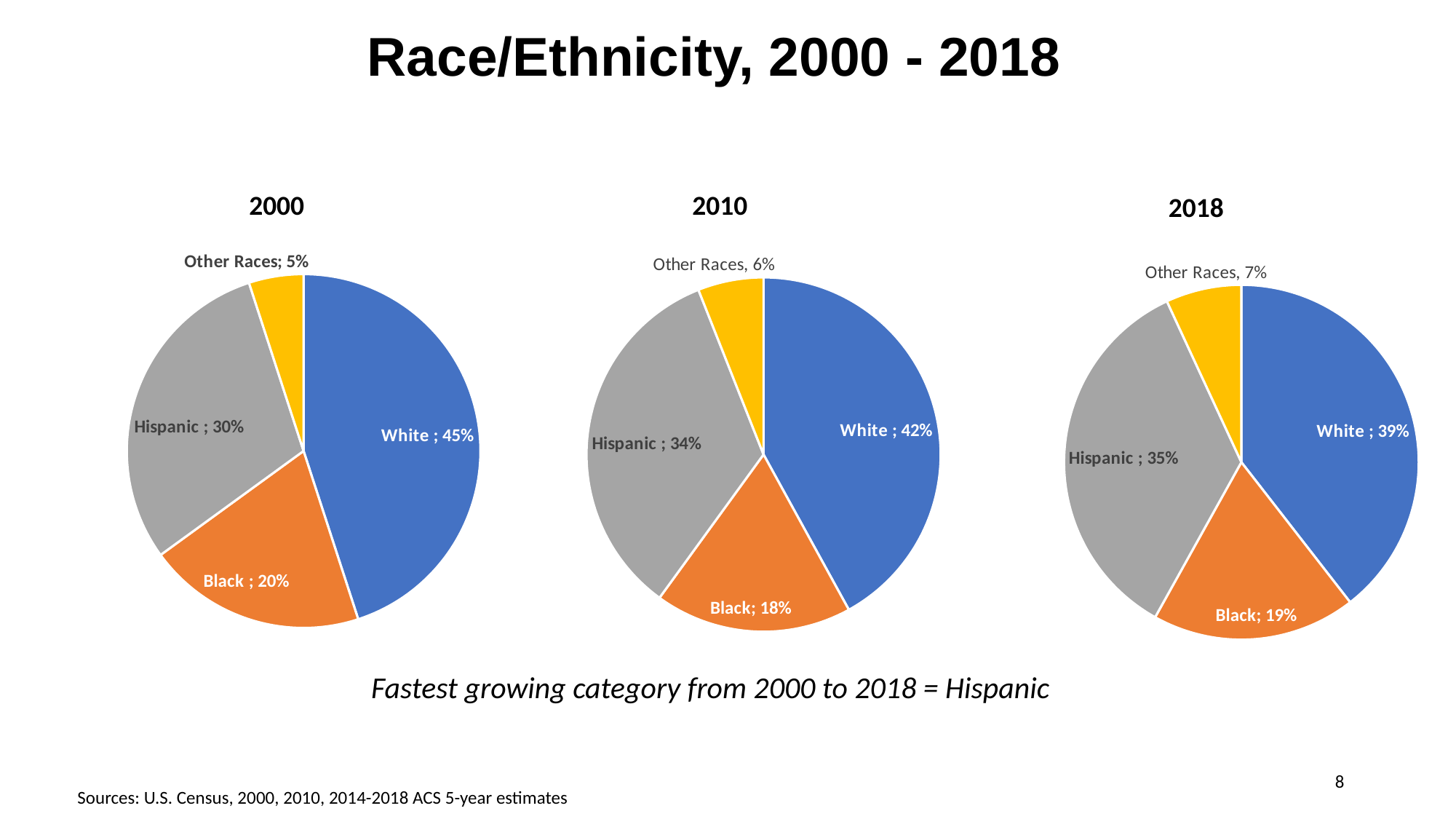
Across the 2000, 2010 and 2018 pie charts, does the White share rise or fall over time? Fall In the 2018 pie chart, what share is labelled for Other Races? 7% How many pie charts are shown on the slide? 3 In the 2000 pie chart, which category has the smallest slice? Other Races In the 2000 pie chart, what share is labelled for White? 45% In the 2018 pie chart, which is larger, the Hispanic slice or the Black slice? Hispanic What kind of chart is used for the 2000 data? Pie chart In the 2010 pie chart, what share is labelled for Hispanic? 34% In the 2018 pie chart, which category has the largest slice? White In the 2010 pie chart, what is the difference between the White and Black shares? 24% How many slices does the 2010 pie chart have? 4 What colour is the Hispanic slice in the 2018 pie chart? Grey